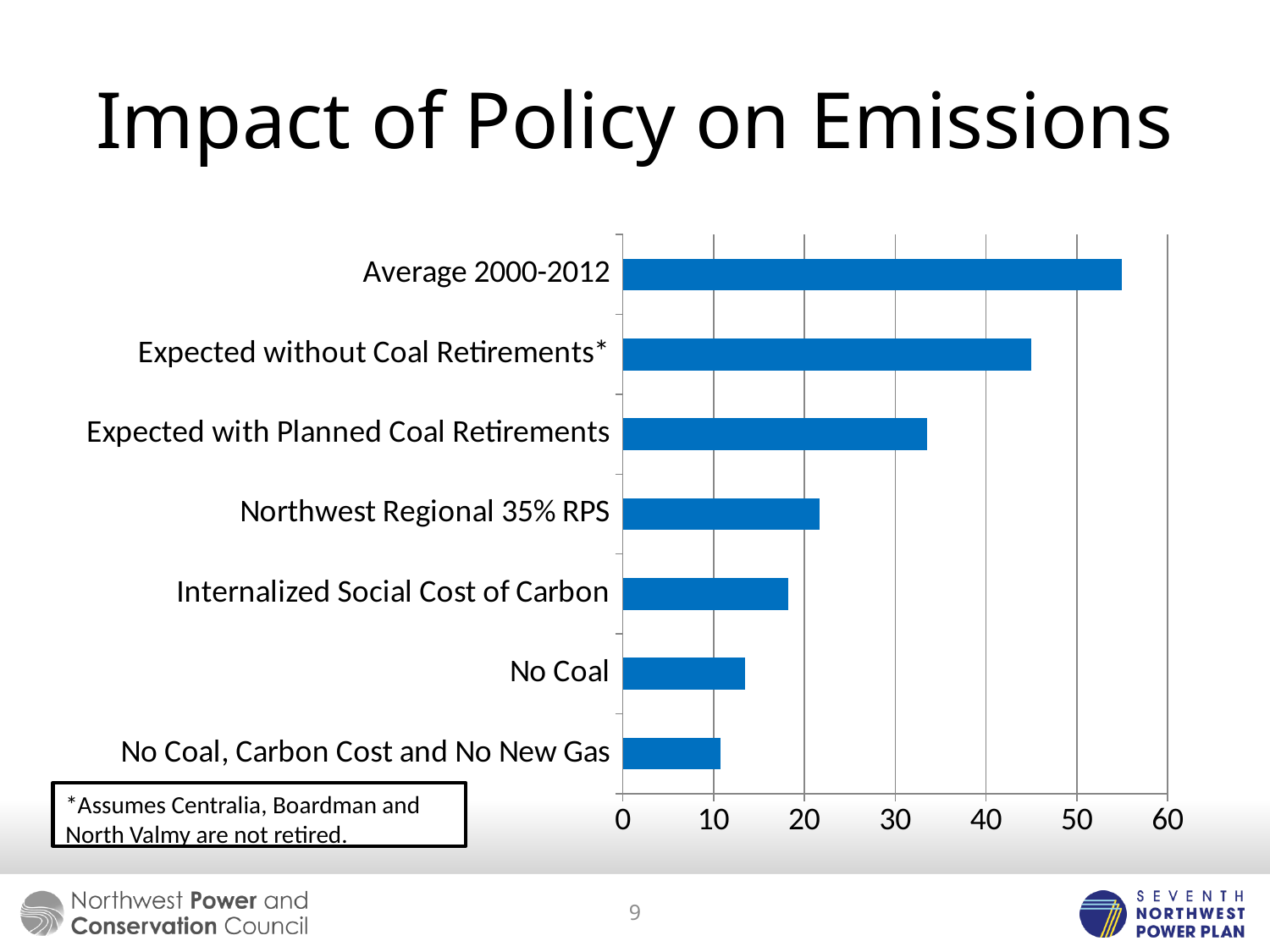
Do the bar values increase or decrease going from the top category to the bottom category? Decrease Is the value for Expected without Coal Retirements* greater or less than 40? greater What is the title of the slide containing the chart? Impact of Policy on Emissions Which category has the highest value? Average 2000-2012 Is the value for No Coal, Carbon Cost and No New Gas greater or less than 20? less Which category has the lowest value? No Coal, Carbon Cost and No New Gas Is the value for Average 2000-2012 greater or less than 50? greater Which is larger, the value for No Coal or the value for Internalized Social Cost of Carbon? Internalized Social Cost of Carbon How many categories are plotted in the chart? 7 What kind of chart is shown on the slide? Bar chart